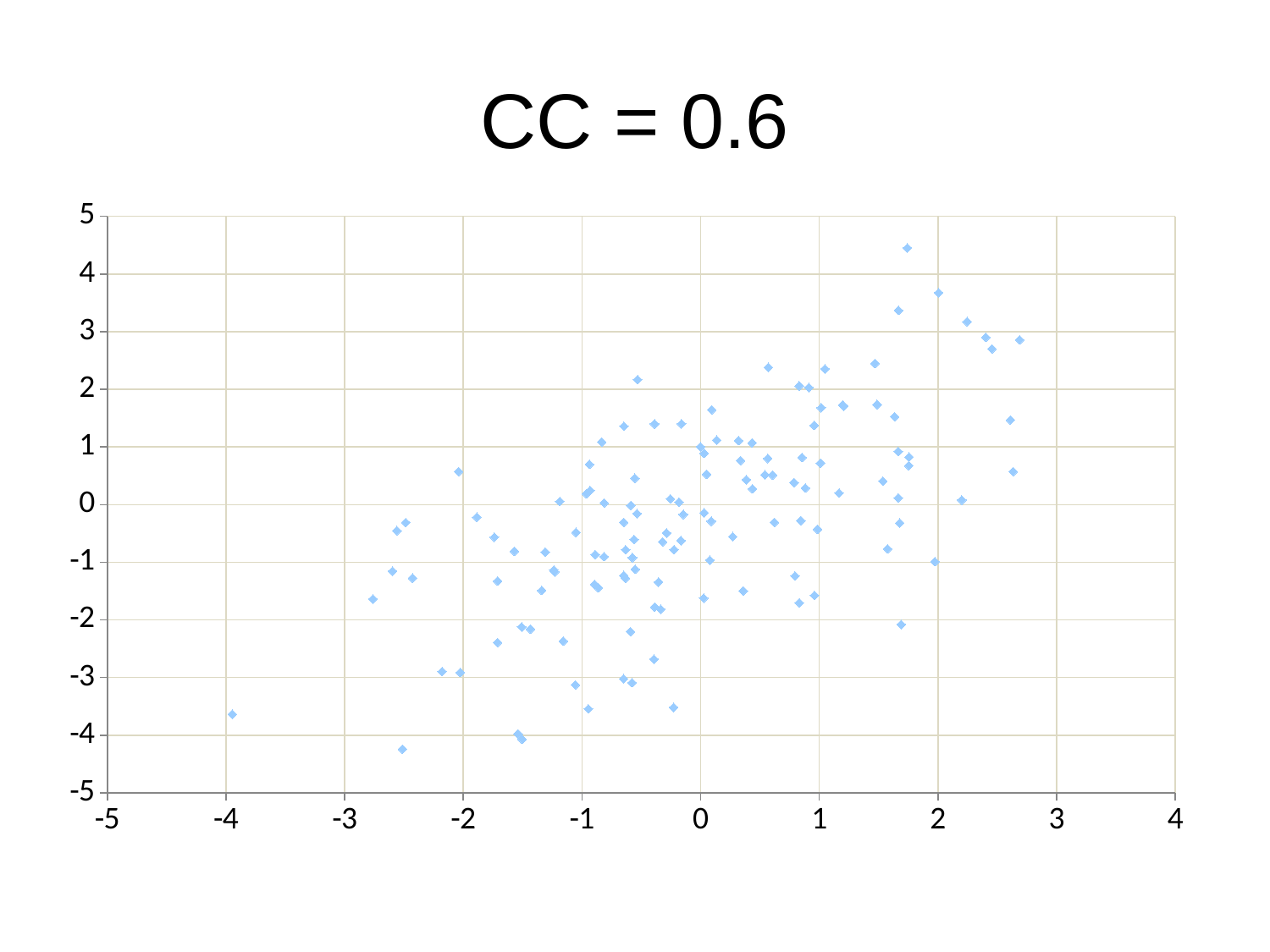
Is the y value of the leftmost point on the chart greater or less than -3? less Is the x value of the leftmost point on the chart greater or less than -3? less Is the y value of the lowest point on the chart greater or less than -4? less What is the title of the chart? CC = 0.6 What kind of chart is shown on the slide? scatter plot Do the y values generally rise or fall as x increases along the x axis? rise What is the maximum value shown on the x axis? 4